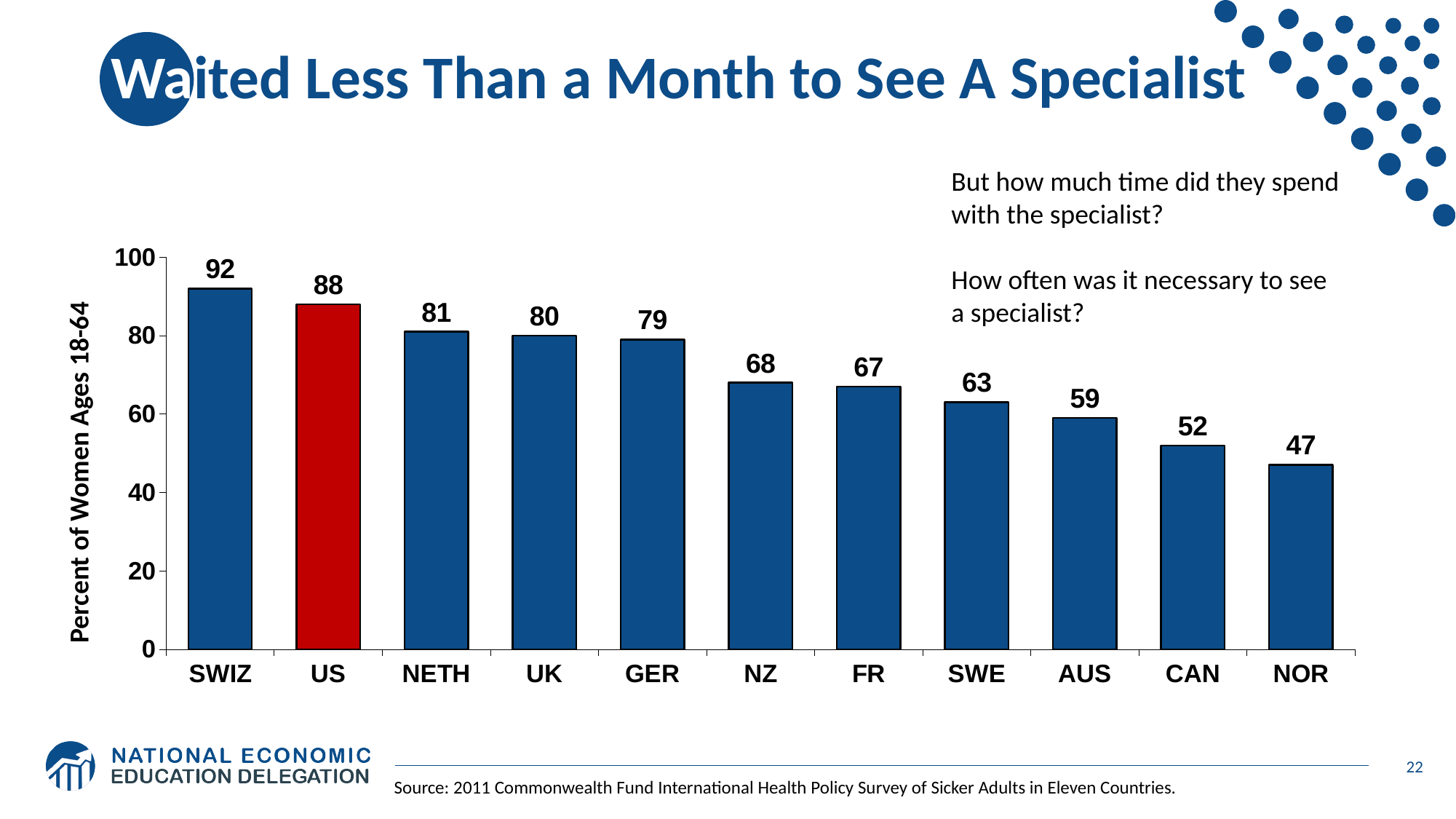
Which country has the lowest value? NOR What is the difference between the values for NETH and CAN? 29 What is the value for NOR? 47 Which is larger, the value for NZ or the value for SWE? NZ What is the value for the US? 88 Is the value for AUS greater or less than 60? less Which country has the highest value? SWIZ Which country's bar is coloured red? US What kind of chart is shown on the slide? bar chart What is the value for GER? 79 How many countries are shown on the x axis? 11 What is the difference between the values for SWIZ and the US? 4